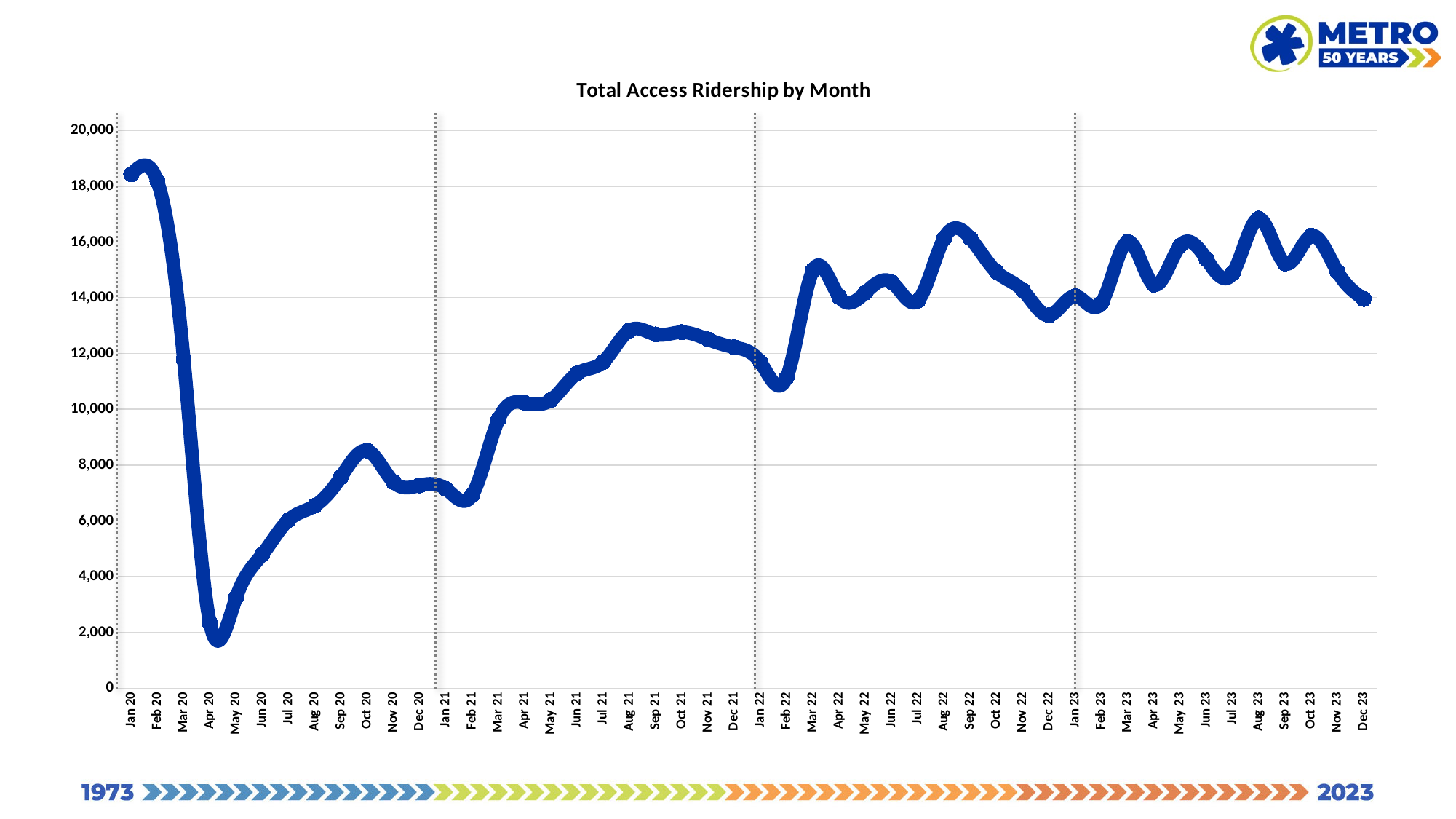
Is the value for Dec 22 greater or less than 14,000? less Which month has the highest ridership? Jan 20 Do the values rise or fall from Jan 20 to Apr 20? fall Which is larger, the value for Oct 20 or the value for Oct 21? Oct 21 Is the value for Feb 21 greater or less than 8,000? less How many months are plotted along the x axis? 48 Is the value for Aug 22 greater or less than 16,000? greater Which month has the lowest ridership? Apr 20 What kind of chart is shown on the slide? line chart What is the title of the chart? Total Access Ridership by Month